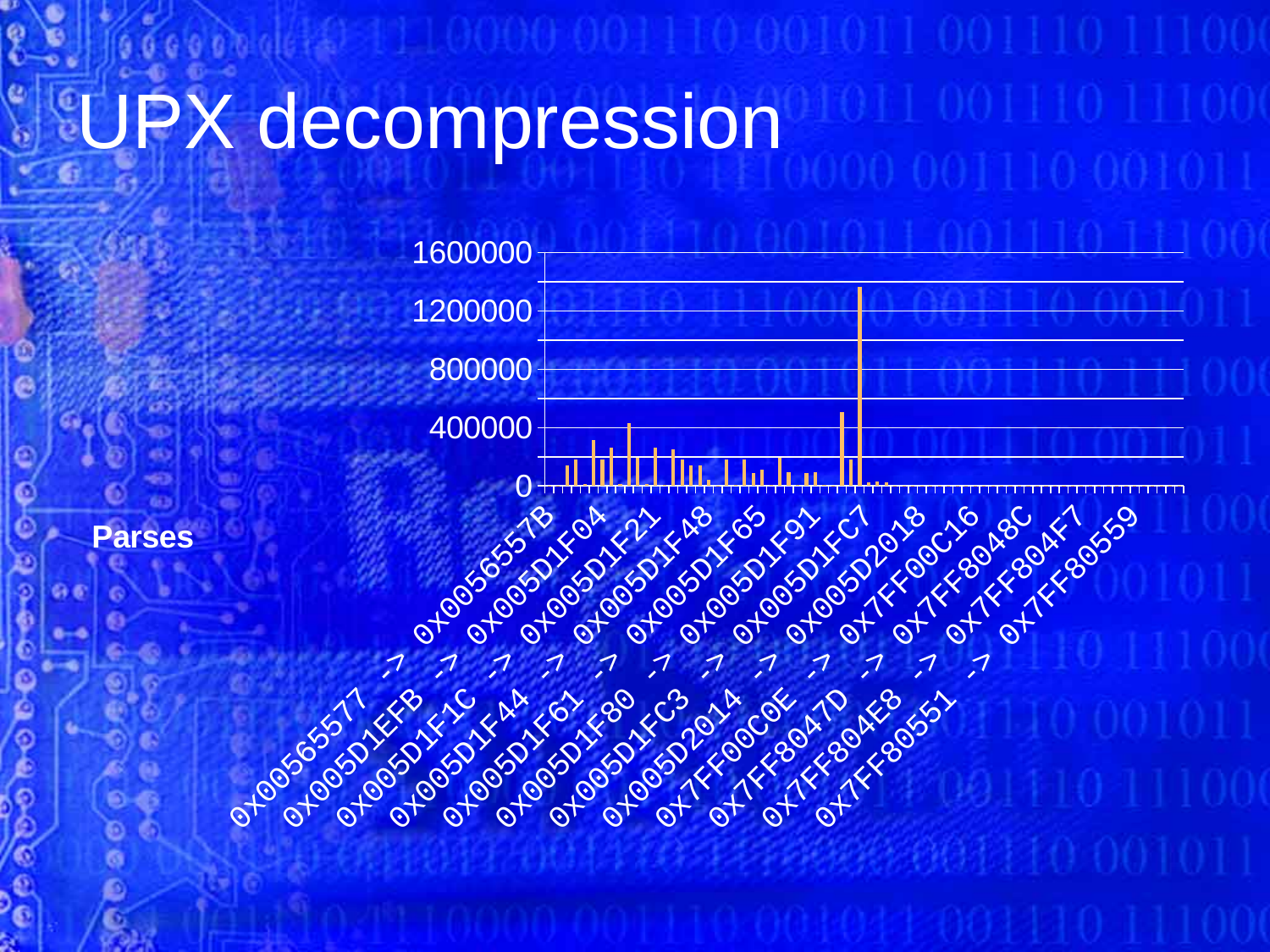
Do the bars in the right-hand portion of the chart (after the tallest bar) generally have higher or lower values than the tallest bar? lower How many bars in the chart exceed 800000? 1 Is the tallest bar in the chart greater or less than 1600000? less Is the value for the last labelled category, 0x7FF80551 -> 0x7FF80559, greater or less than 400000? less What kind of chart is shown on the slide? bar chart What is the highest value shown on the vertical axis of the chart? 1600000 What is the label on the vertical axis of the chart? Parses Is the tallest bar in the chart greater or less than 1200000? greater